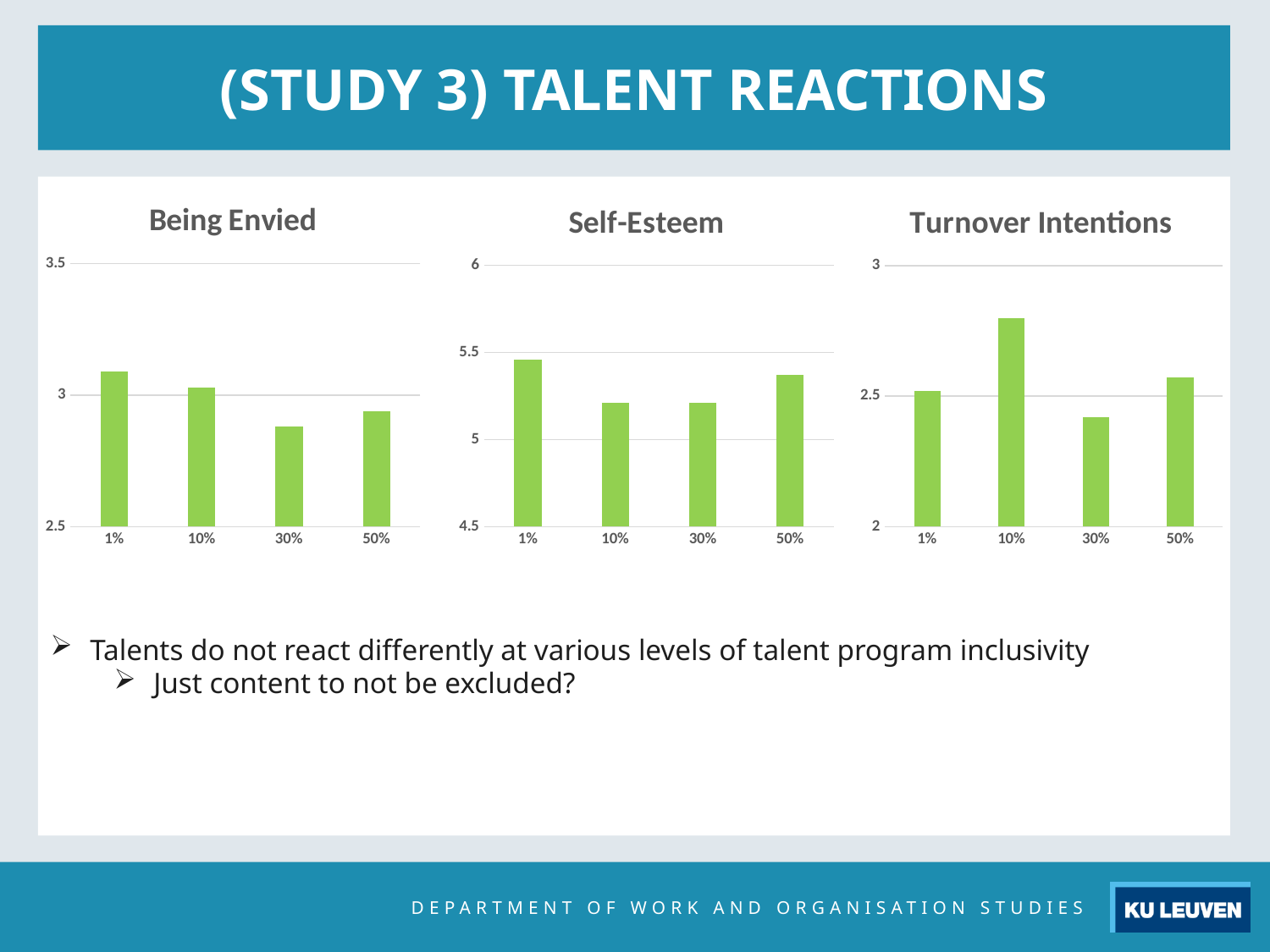
In the Self-Esteem chart, which inclusivity level has the highest bar? 1% In the Self-Esteem chart, is the value for 1% greater or less than 5.5? less In the Being Envied chart, which inclusivity level has the lowest bar? 30% In the Turnover Intentions chart, which inclusivity level has the highest bar? 10% In the Turnover Intentions chart, is the value for 30% greater or less than 2.5? less In the Being Envied chart, is the value for 1% greater or less than 3? greater In the Turnover Intentions chart, which inclusivity level has the lowest bar? 30% What kind of chart is the Turnover Intentions chart? Bar chart In the Being Envied chart, which inclusivity level has the highest bar? 1% How many categories are shown on the x axis of the Self-Esteem chart? 4